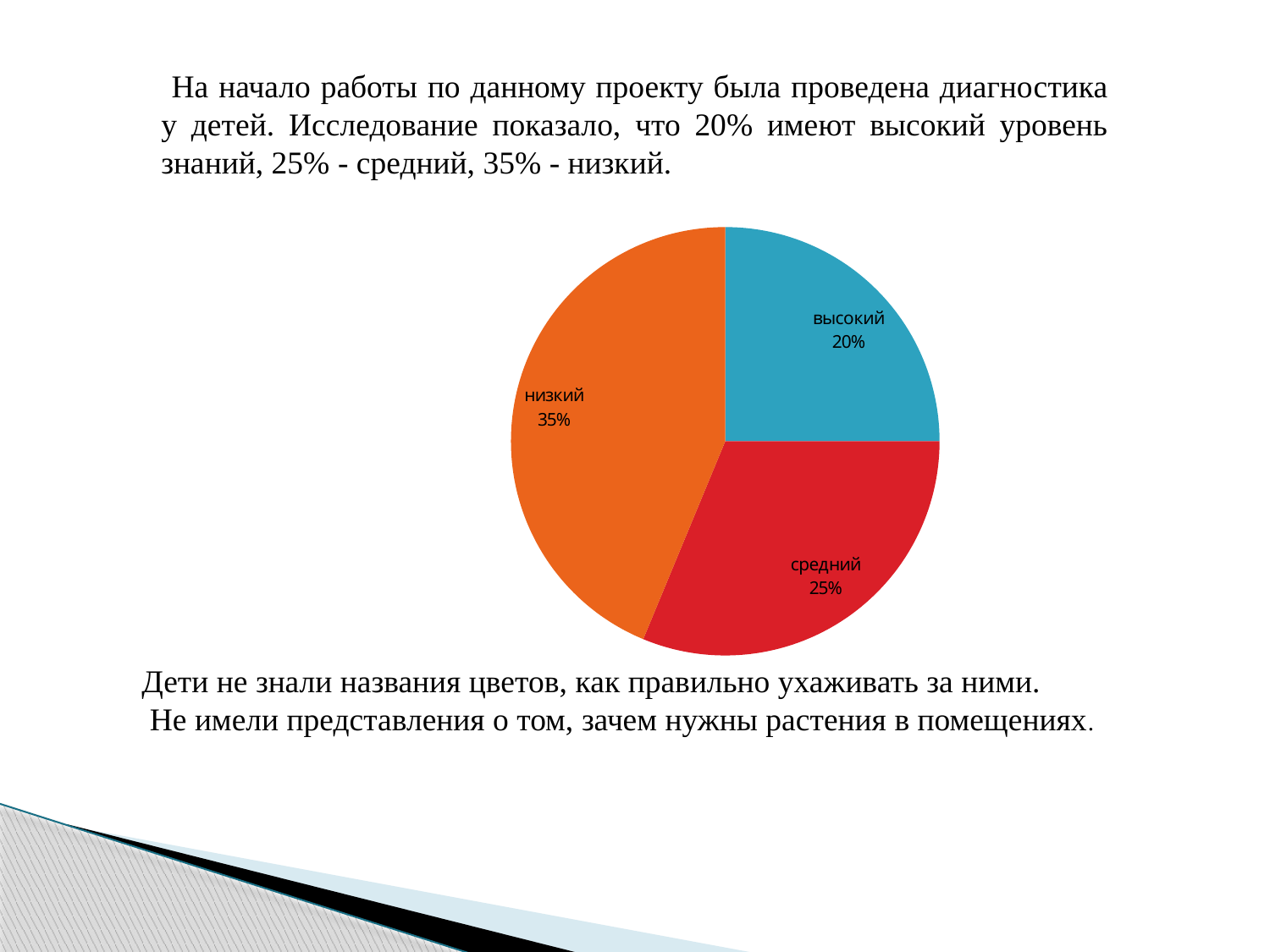
Which slice of the pie chart is the smallest? высокий What is the difference between the labelled values for "средний" and "высокий"? 5% What is the difference between the labelled values for "низкий" and "высокий"? 15% Which slice of the pie chart is the largest? низкий Which slice is larger, "низкий" or "средний"? низкий What percentage is shown for the "средний" slice of the pie chart? 25% What percentage is shown for the "высокий" slice of the pie chart? 20% How many slices does the pie chart have? 3 What percentage is shown for the "низкий" slice of the pie chart? 35% What colour is the "высокий" slice of the pie chart? blue What colour is the "низкий" slice of the pie chart? orange What kind of chart is shown on the slide? pie chart